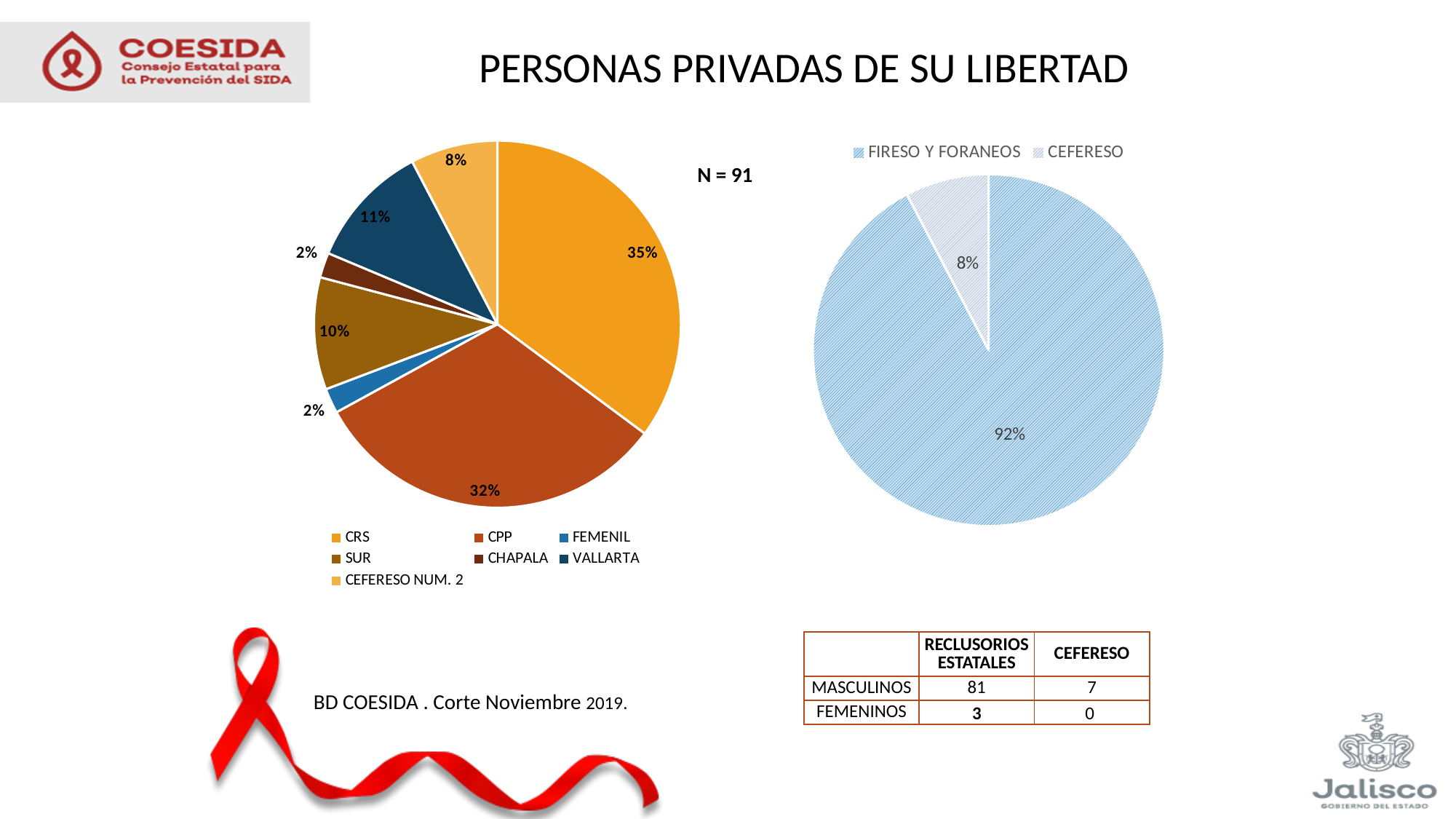
How many categories does the legend of the left pie chart list? 7 In the right pie chart, what share does FIRESO Y FORANEOS have? 92% What kind of chart is the chart on the right of the slide? Pie chart In the right pie chart, what share does CEFERESO have? 8% In the left pie chart, what share does CRS have? 35% In the left pie chart, what is the difference between the CRS and CPP shares? 3% In the left pie chart, which is larger, the VALLARTA slice or the SUR slice? VALLARTA What is the N value shown next to the left pie chart? N = 91 In the left pie chart, which category has the largest slice? CRS